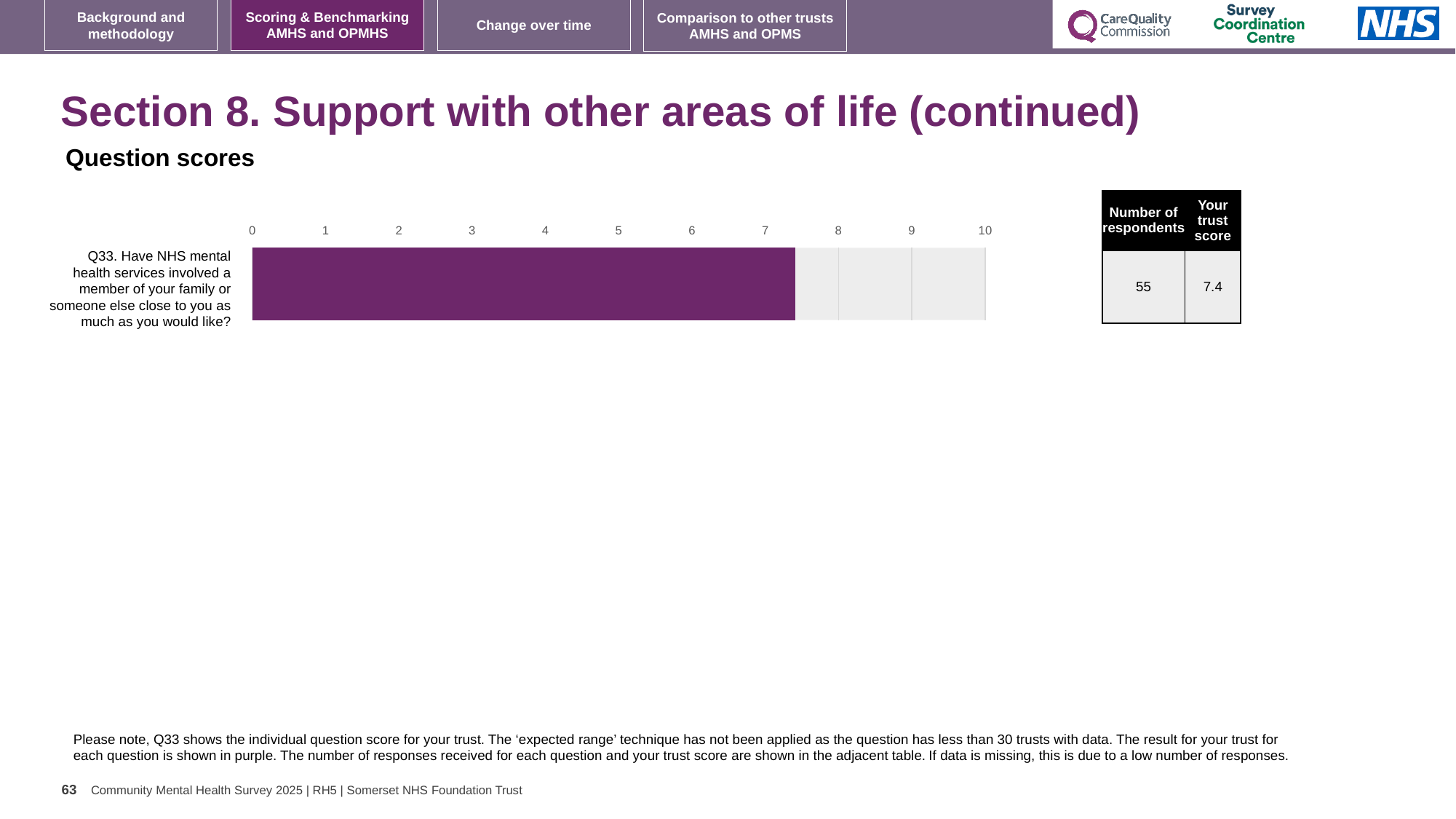
What is the maximum value shown on the chart's horizontal axis? 10 How many respondents answered Q33 according to the table next to the chart? 55 How many questions (categories) are plotted in the bar chart? 1 What is the trust score for Q33 shown on the slide? 7.4 Is the value of the bar for Q33 greater or less than 7? greater Is the value of the bar for Q33 greater or less than 8? less Is the value of the bar for Q33 greater or less than 5? greater What kind of chart is shown on the slide? Bar chart What colour is the bar for Q33 in the chart? Purple